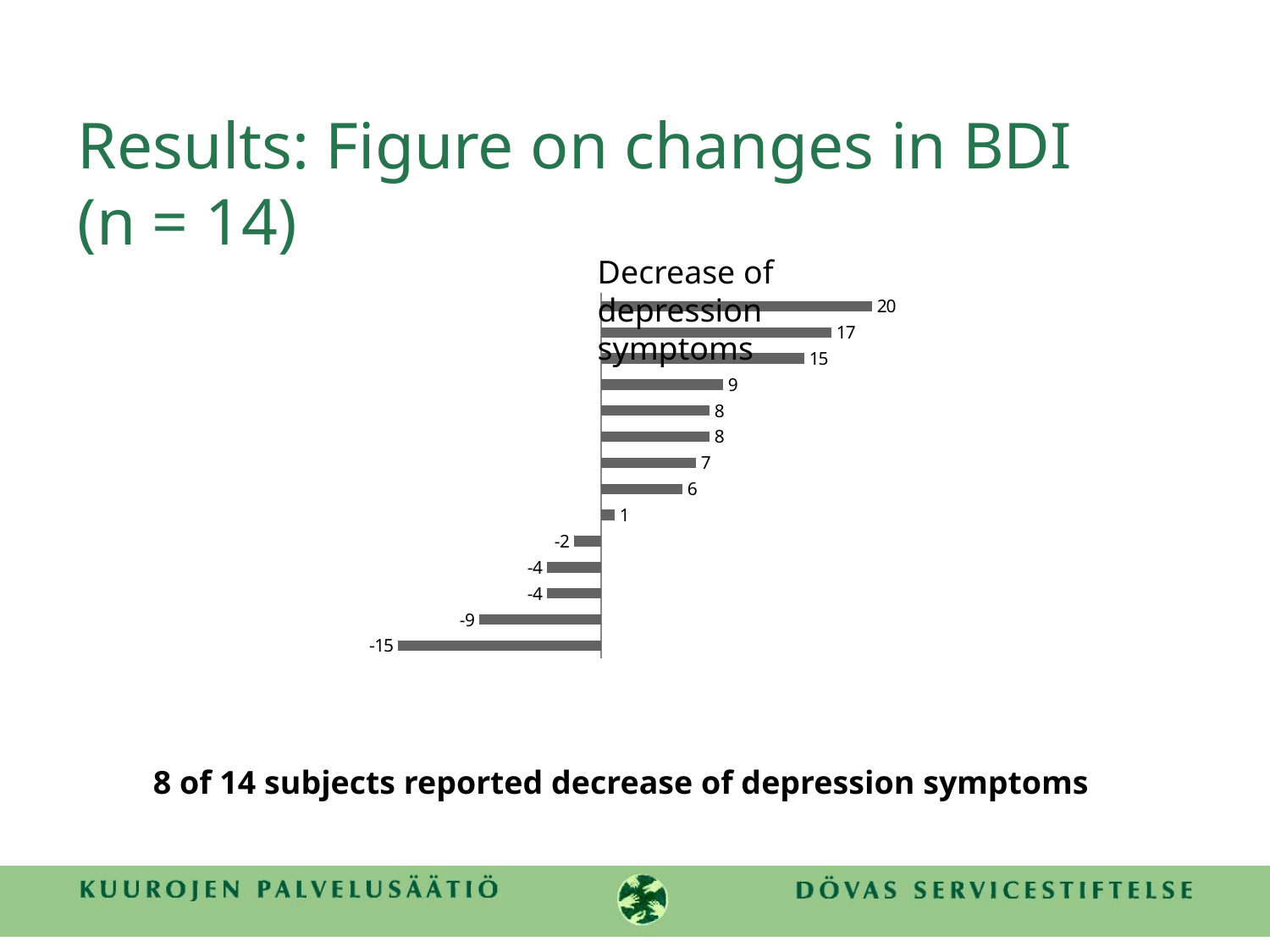
What is the difference between the highest value (20) and the second highest value (17)? 3 What kind of chart is shown on the slide? bar chart What is the value of the bottom bar in the chart? -15 How many bars in the chart have negative values? 5 What is the value of the second bar from the top? 17 What is the difference between the highest value (20) and the lowest value (-15)? 35 What is the highest value shown in the chart? 20 What is the lowest value shown in the chart? -15 Do the bar values increase or decrease going from the top of the chart to the bottom? decrease What is the value of the topmost bar in the chart? 20 How many bars are plotted in the chart? 14 What is the title of the chart? Decrease of depression symptoms